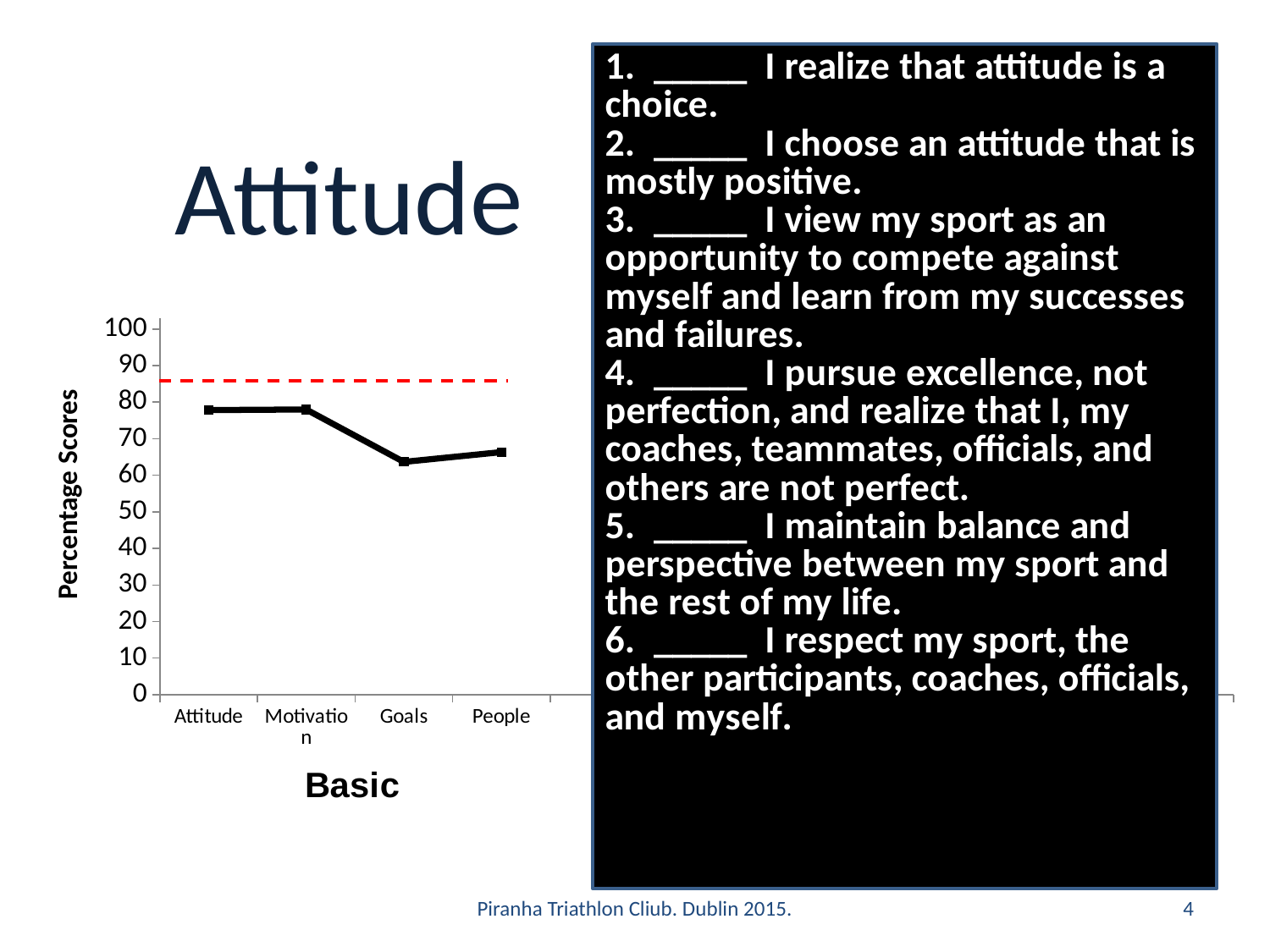
What kind of chart is shown on the slide? line chart Which has the larger value, Motivation or People? Motivation Is the value for People greater or less than 80? less Is the value for Attitude greater or less than 90? less What is the title of the vertical axis? Percentage Scores Is the value for Attitude greater or less than 70? greater Does the line rise or fall from Motivation to Goals? fall What is the title of the horizontal axis? Basic Which has the larger value, Attitude or Goals? Attitude